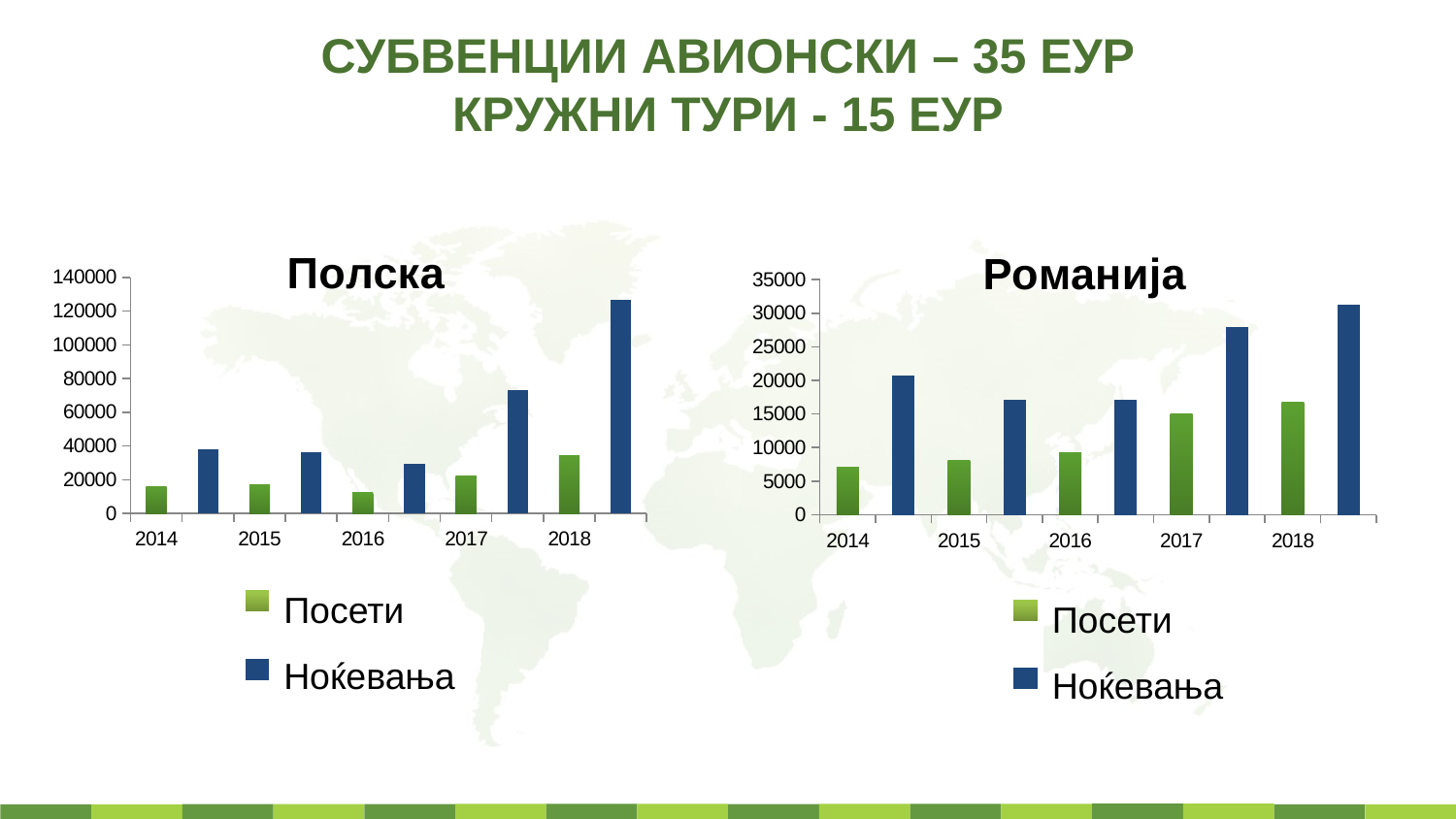
How many series does the legend of the Романија chart list? 2 What kind of chart is the Полска chart? bar chart In the Полска chart, which year has the lowest value for Посети? 2016 In the Романија chart, which year has the lowest value for Посети? 2014 In the Полска chart, is the value for Посети in 2017 greater or less than 40000? less In the Романија chart, is the value for Ноќевања in 2017 greater or less than 25000? greater In the Романија chart, which year has the highest value for Ноќевања? 2018 In the Полска chart, which year has the highest value for Ноќевања? 2018 In the Романија chart, do the values for Посети rise or fall from 2014 to 2018? rise In the Романија chart, which is larger in 2014: Посети or Ноќевања? Ноќевања In the Полска chart, is the value for Ноќевања in 2018 greater or less than 120000? greater How many years are shown on the x axis of the Полска chart? 5